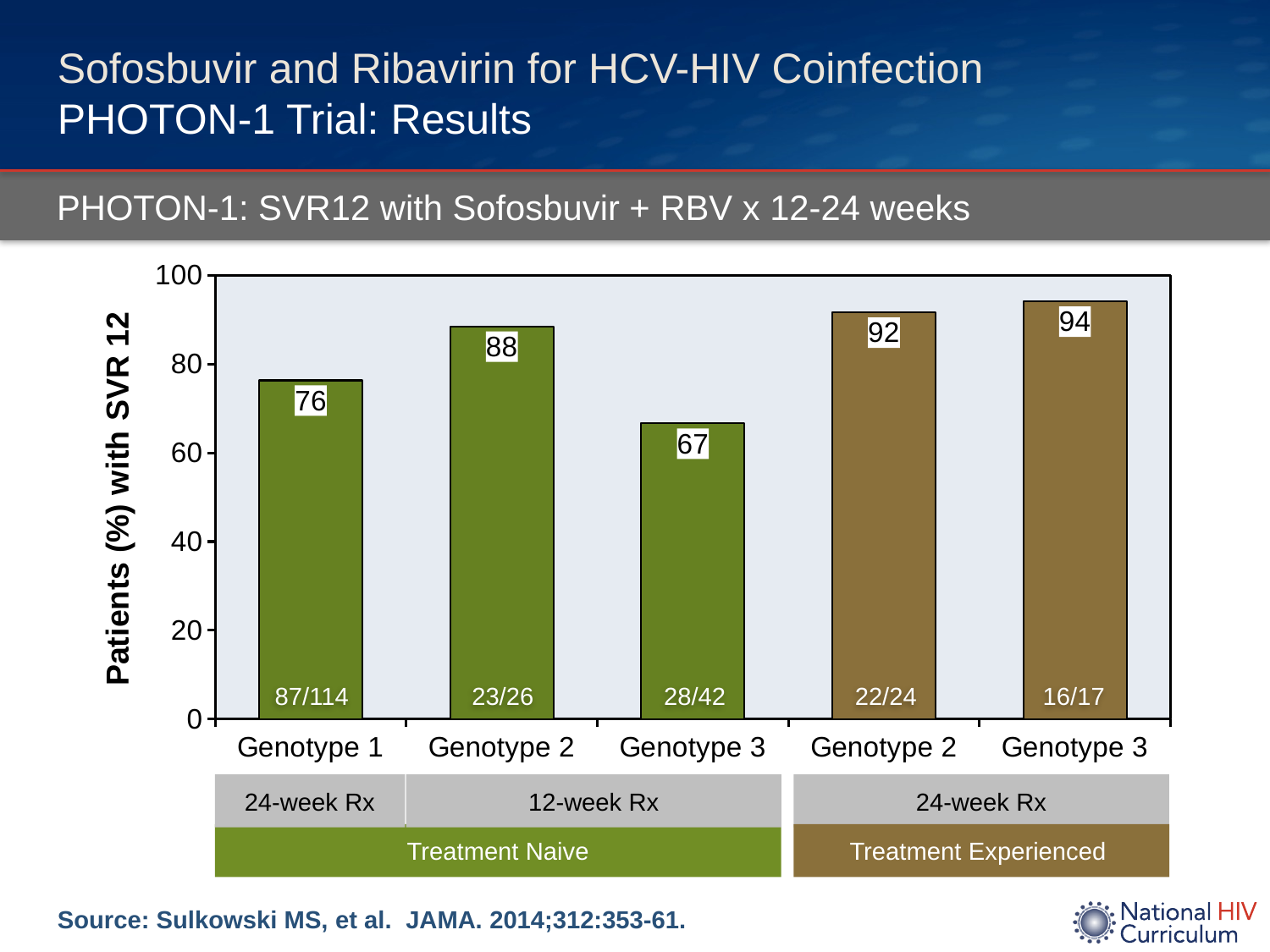
How many bars are shown in the chart? 5 What type of chart is shown on the slide? Bar chart How many patients achieved SVR12 out of the total in the treatment-naive Genotype 2 group, as labeled on the bar? 23/26 What is the label of the y-axis? Patients (%) with SVR 12 What is the SVR12 rate for treatment-naive Genotype 3 patients? 67 Which has a higher SVR12 rate: treatment-naive Genotype 1 or treatment-naive Genotype 2? Treatment Naive Genotype 2 Which group has the highest SVR12 rate? Treatment Experienced Genotype 3 What is the SVR12 rate for treatment-naive Genotype 1 patients? 76 Which group has the lowest SVR12 rate? Treatment Naive Genotype 3 What is the difference in SVR12 rate between treatment-experienced Genotype 2 and treatment-naive Genotype 2? 4 What is the SVR12 rate for treatment-experienced Genotype 3 patients? 94 Is the SVR12 rate for treatment-naive Genotype 3 greater or less than 80? less